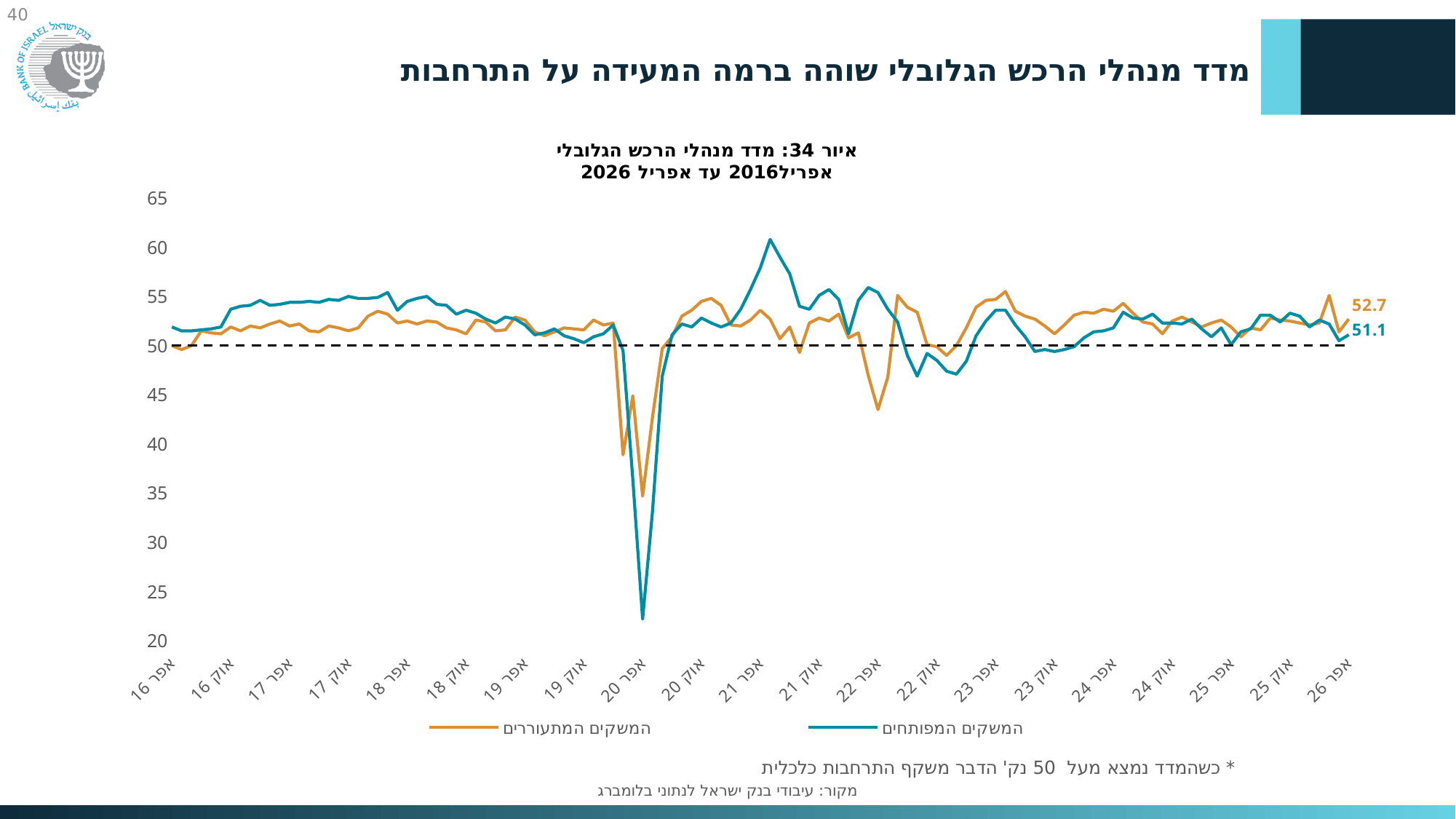
What is the latest value shown for the developed markets series (המשקים המפותחים)? 51.1 Is the peak of the developed markets series around April 2021 greater or less than 55? greater Is the lowest value of the emerging markets series, around April 2020, greater or less than 40? less How many series does the legend list? 2 Is the lowest value of the developed markets series, around April 2020, greater or less than 30? less What is the latest value shown for the emerging markets series (המשקים המתעוררים)? 52.7 What kind of chart is shown on the slide? Line chart At what level is the horizontal dashed reference line drawn? 50 At the end of the series, which is higher: the emerging markets value or the developed markets value? Emerging markets (המשקים המתעוררים) What is the title of the chart? איור 34: מדד מנהלי הרכש הגלובלי אפריל2016 עד אפריל 2026 What is the difference between the latest labelled values of the emerging markets series and the developed markets series? 1.6 Which series reaches the lowest point on the chart? Developed markets (המשקים המפותחים)